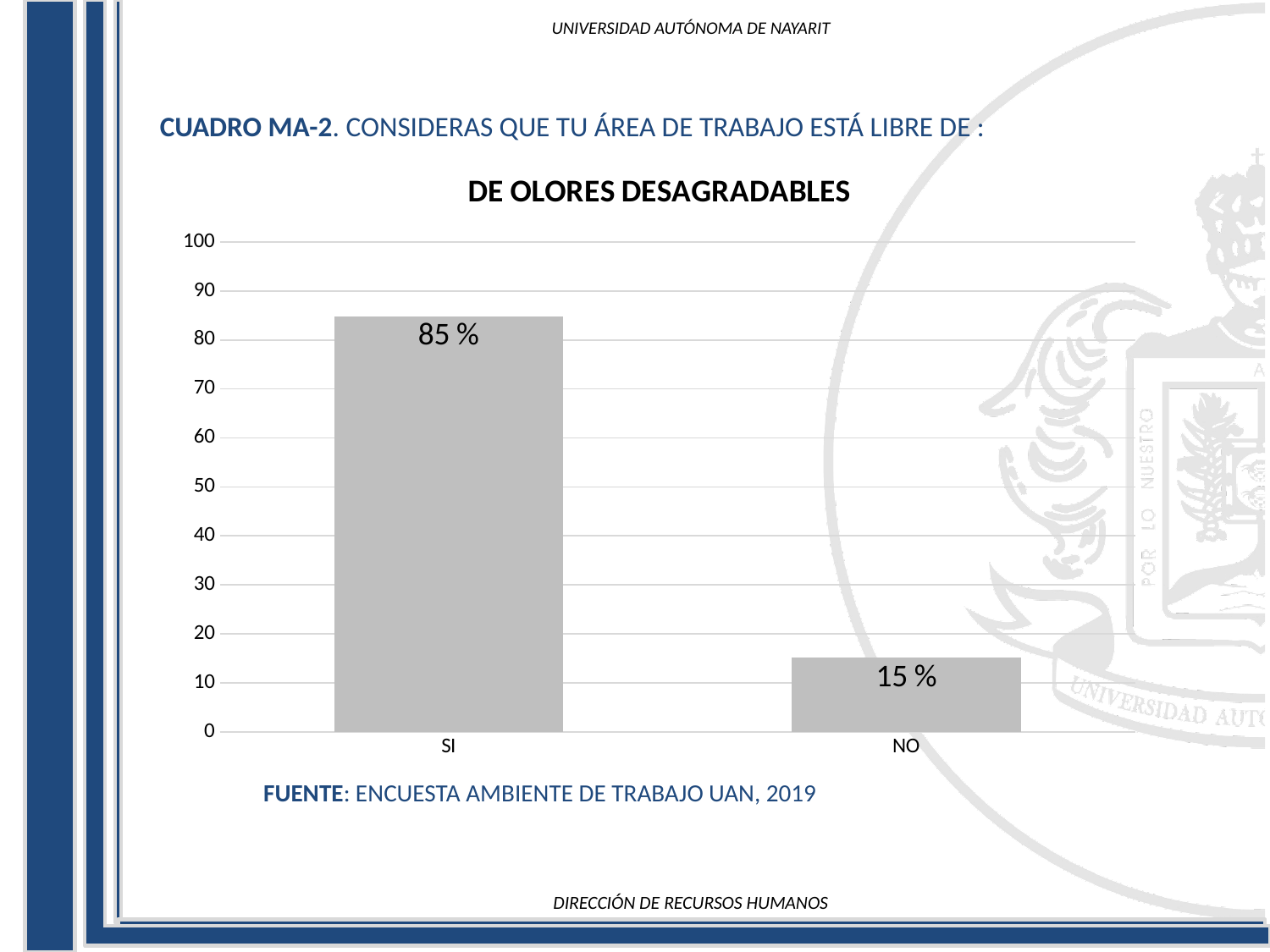
Which category has the highest value? SI What kind of chart is shown on the slide? bar chart What is the title of the chart? DE OLORES DESAGRADABLES Which category has the lowest value? NO What is the value for NO? 15 % Is the value for NO greater or less than 20? less How many categories are shown on the x axis? 2 What is the difference between the values for SI and NO? 70 % What is the highest value shown on the vertical axis? 100 What is the value for SI? 85 % Is the value for SI greater or less than 80? greater Which is larger, the value for SI or the value for NO? SI